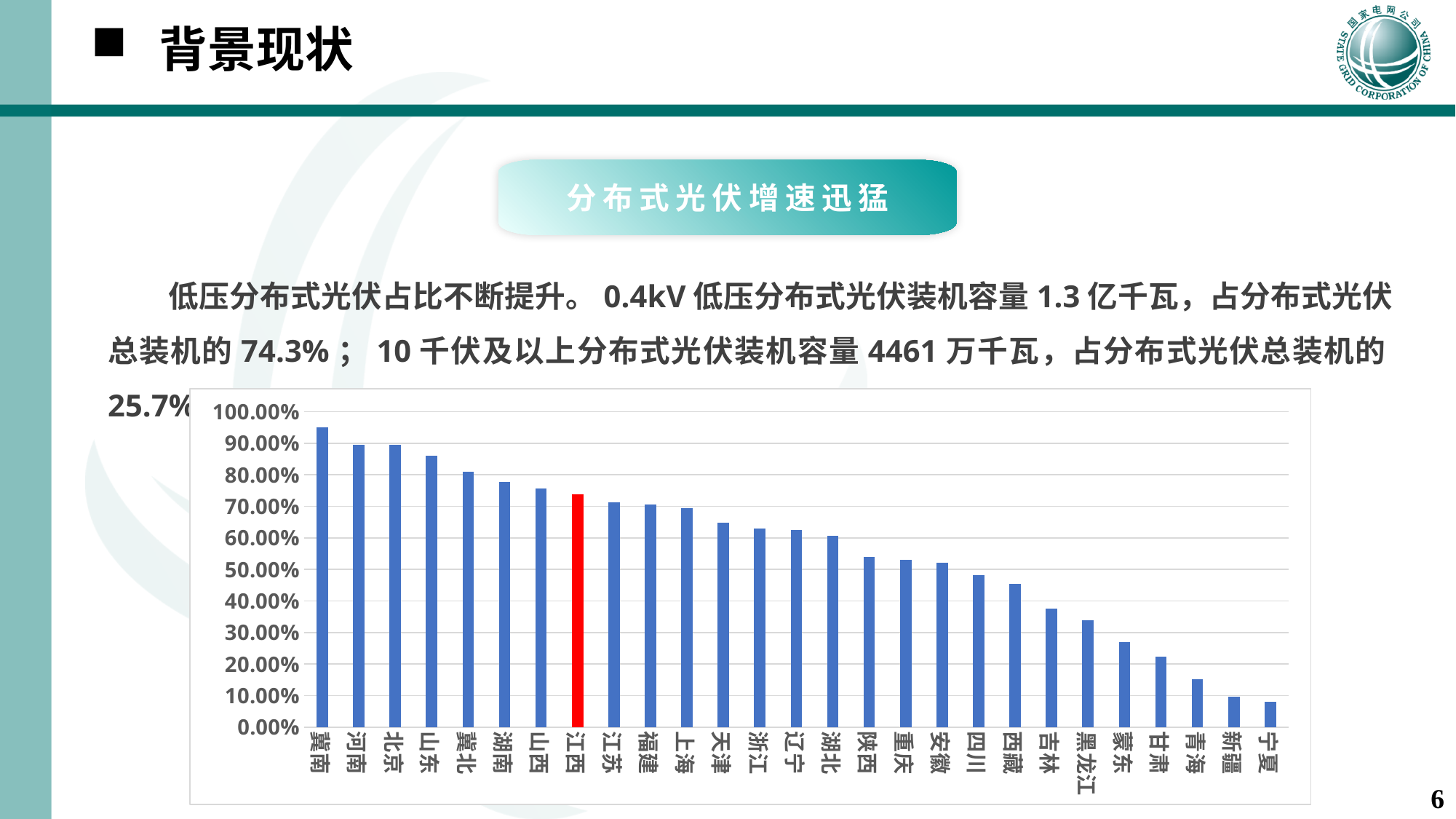
What kind of chart is shown on the slide? bar chart Is the value for 江西 greater or less than 70.00%? greater Is the value for 西藏 greater or less than 50.00%? less Is the value for 黑龙江 greater or less than 40.00%? less Which category has the lowest value in the chart? 宁夏 Which category's bar is highlighted in red? 江西 Do the values rise or fall moving from left to right along the x axis? fall How many provinces/regions are shown on the x axis of the chart? 27 Which category has the highest value in the chart? 冀南 Which has a larger value, 山东 or 湖北? 山东